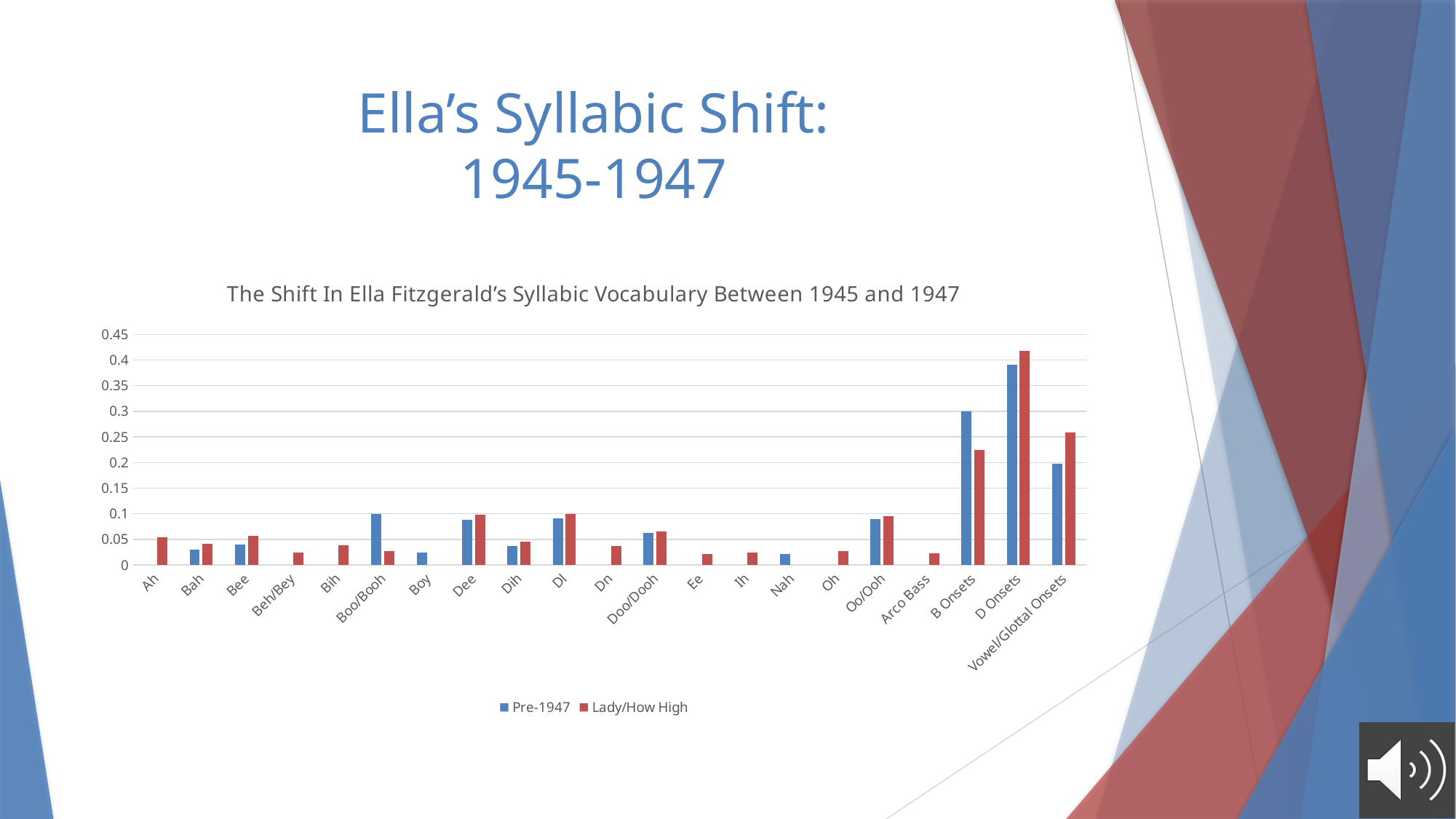
Is the Pre-1947 value for Bee greater or less than 0.05? less For B Onsets, which series has the larger value, Pre-1947 or Lady/How High? Pre-1947 Which category has the highest Pre-1947 value in the chart? D Onsets How many syllable categories are shown along the x axis of the chart? 21 What is the title of the chart on the slide? The Shift In Ella Fitzgerald's Syllabic Vocabulary Between 1945 and 1947 How many series does the chart legend list? 2 What kind of chart is shown on the slide? Bar chart For Boo/Booh, which series has the larger value, Pre-1947 or Lady/How High? Pre-1947 For Vowel/Glottal Onsets, which series has the larger value, Pre-1947 or Lady/How High? Lady/How High Is the Lady/How High value for B Onsets greater or less than 0.2? greater Is the Lady/How High value for D Onsets greater or less than 0.4? greater Which category has the highest Lady/How High value in the chart? D Onsets